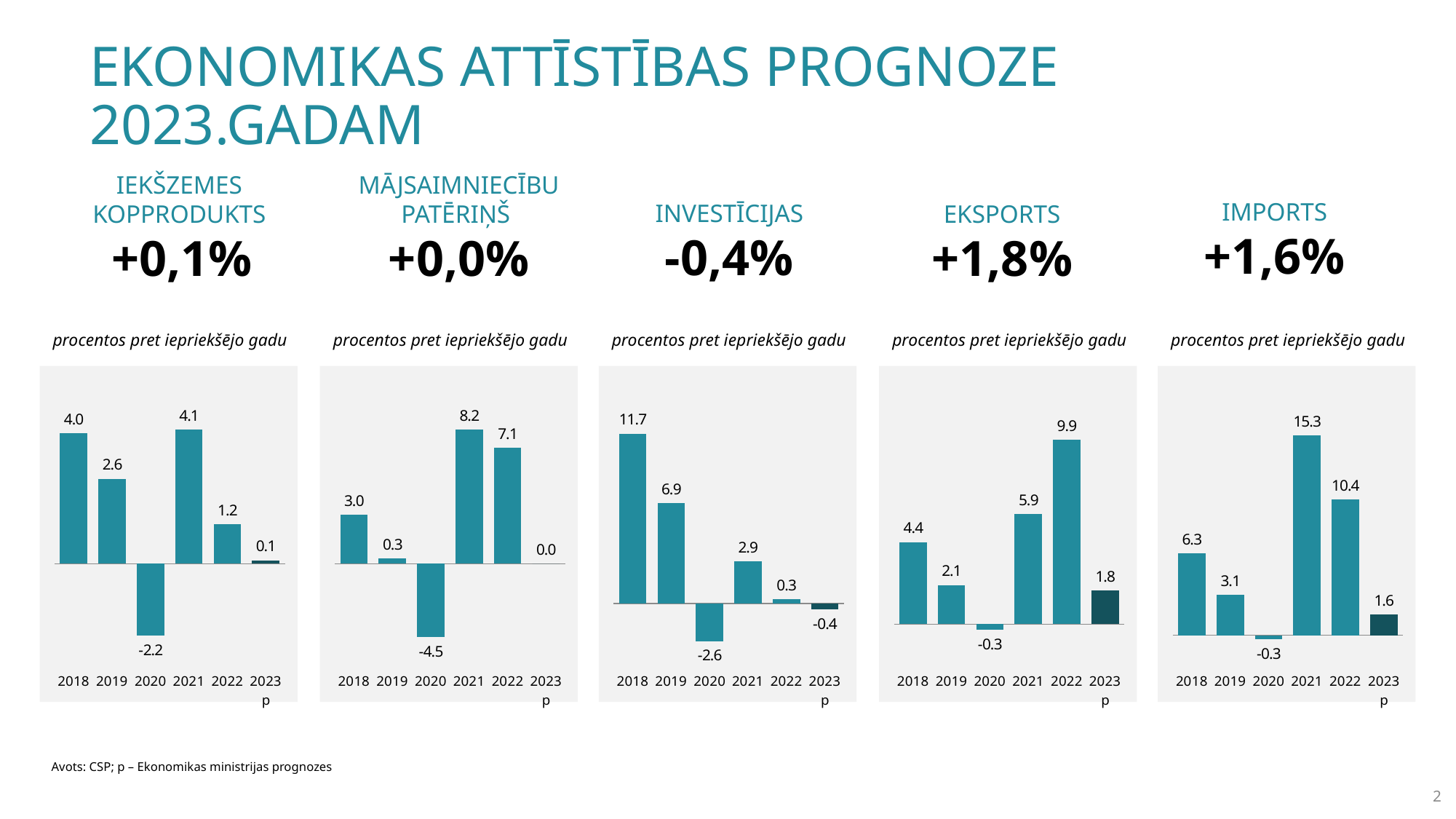
In the INVESTĪCIJAS chart, what is the value for 2023? -0.4 How many years are shown on the x axis of the EKSPORTS chart? 6 In the EKSPORTS chart, which is larger, the value for 2018 or the value for 2021? 2021 In the EKSPORTS chart, what is the value for 2022? 9.9 In the IEKŠZEMES KOPPRODUKTS chart, which year has the lowest value? 2020 In the MĀJSAIMNIECĪBU PATĒRIŅŠ chart, what is the value for 2020? -4.5 In the MĀJSAIMNIECĪBU PATĒRIŅŠ chart, which year has the highest value? 2021 In the IMPORTS chart, which year has the highest value? 2021 In the IEKŠZEMES KOPPRODUKTS chart, what is the value for 2021? 4.1 What type of chart is the IMPORTS chart? Bar chart In the INVESTĪCIJAS chart, what is the difference between the 2018 and 2019 values? 4.8 In the IMPORTS chart, what is the difference between the 2021 and 2022 values? 4.9